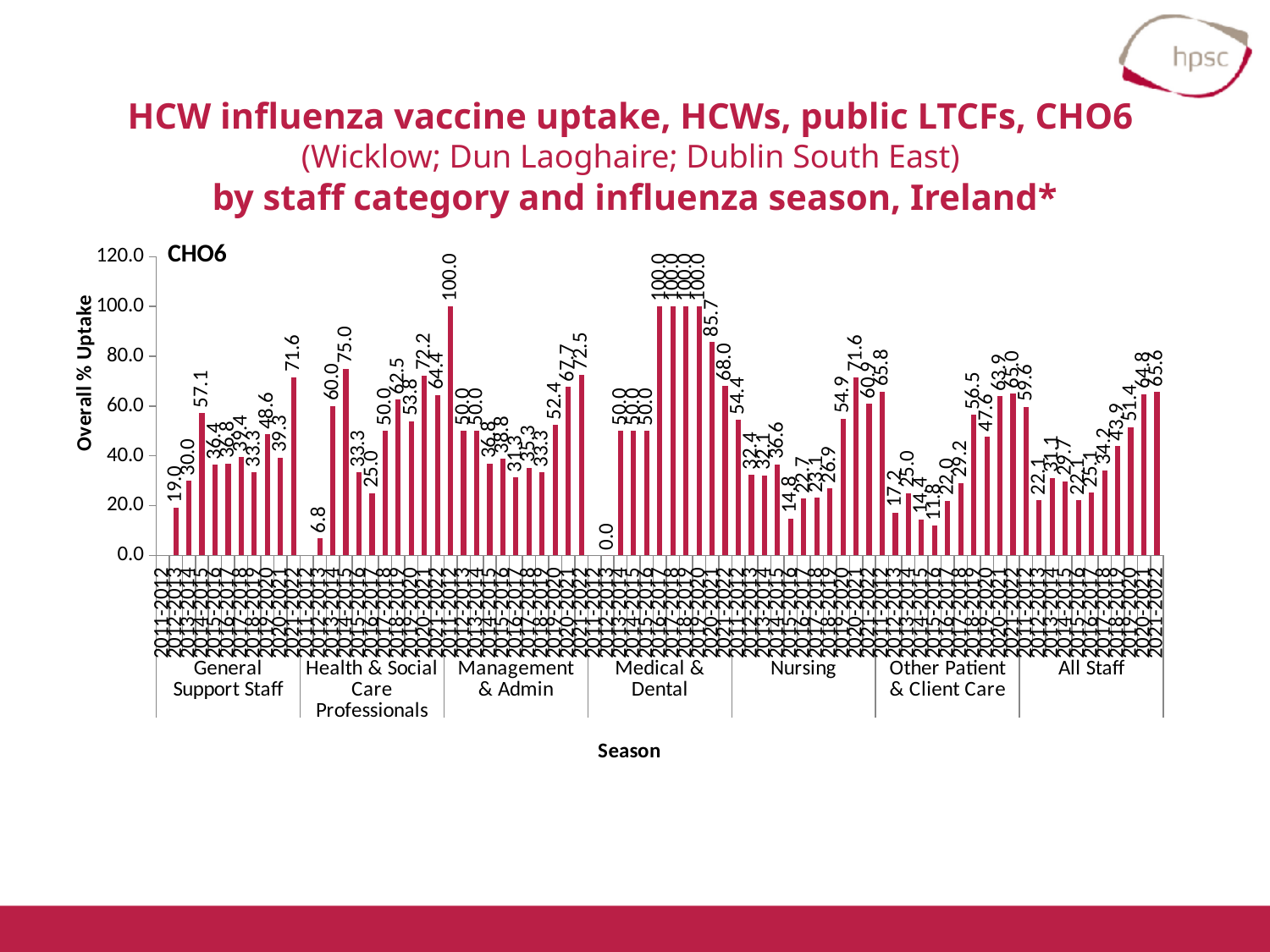
Do the values in the All Staff group generally rise or fall from left to right? Rise What is the highest value in the Nursing group? 71.6 What is the title of the vertical axis? Overall % Uptake What is the lowest value shown on the chart, and in which staff category group does it appear? 0.0, Medical & Dental What is the highest value shown on the chart? 100.0 How many staff category groups are shown along the x axis? 7 What is the value of the last bar in the All Staff group? 65.6 What is the value of the first bar in the Health & Social Care Professionals group? 6.8 What type of chart is shown on the slide? Bar chart Which is larger: the last bar in the Nursing group or the last bar in the Other Patient & Client Care group? Other Patient & Client Care What is the lowest value in the Other Patient & Client Care group? 11.8